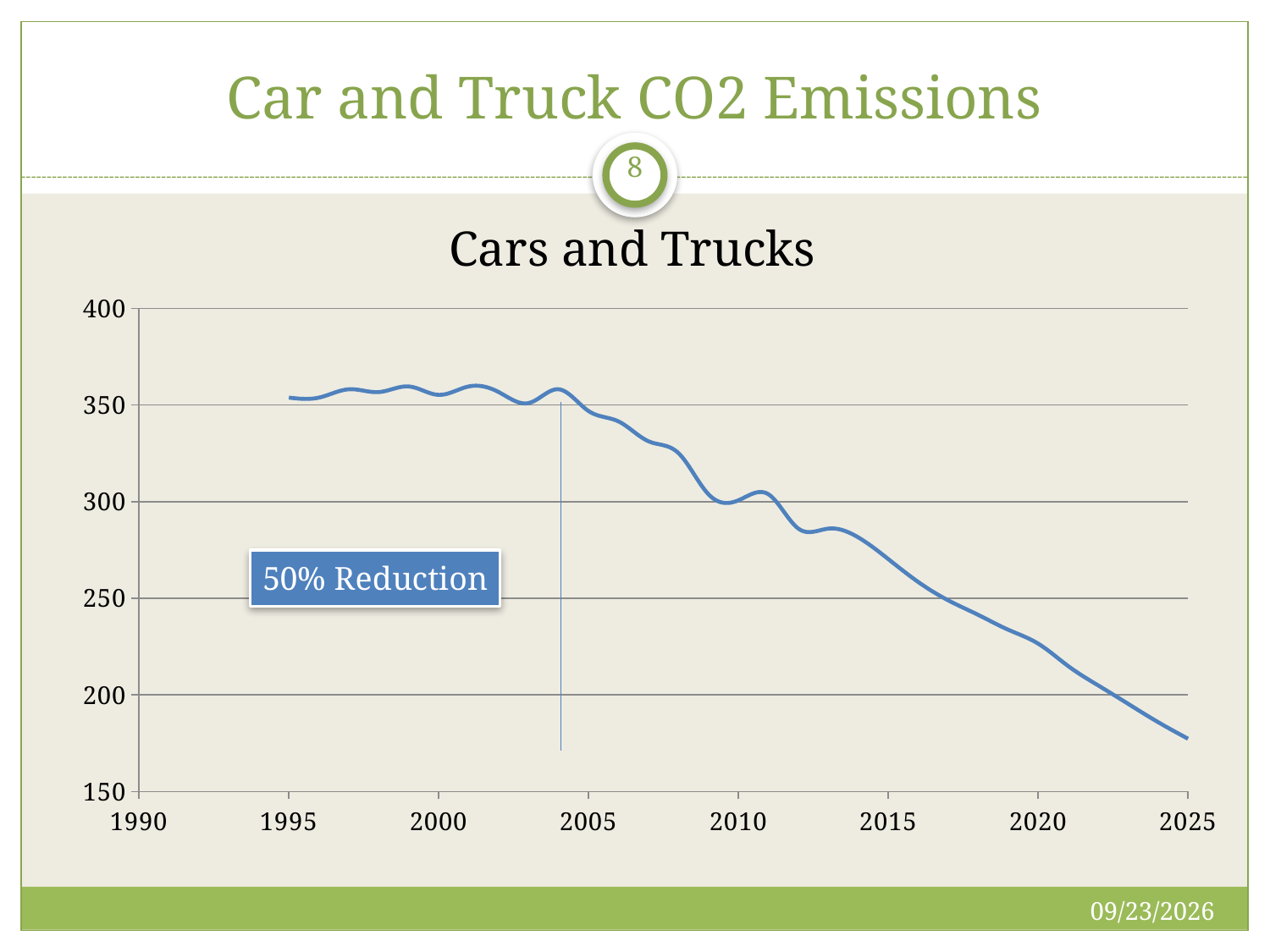
Is the value for 2005 greater or less than 300? greater Is the value for 1995 greater or less than 300? greater Do the values rise or fall along the x axis from 2005 to 2025? fall Is the value for 2025 greater or less than 200? less What is the title of the chart? Cars and Trucks Which is larger, the value for 2005 or the value for 2015? 2005 Which year shown has the lowest value on the line? 2025 What does the text box on the chart say? 50% Reduction What kind of chart is shown on the slide? line chart